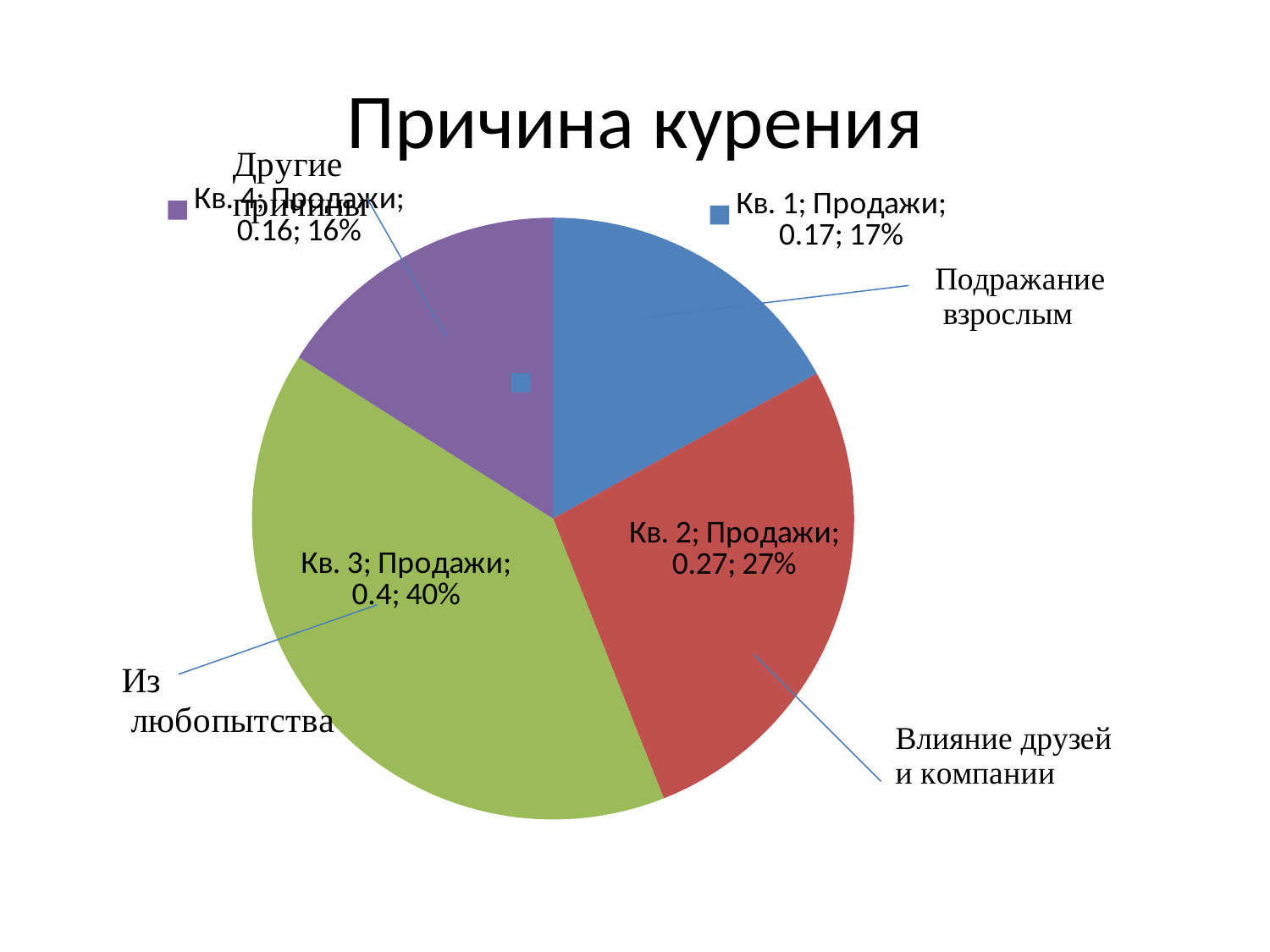
What value is shown for the Кв. 1 slice? 0.17 What is the title of the chart? Причина курения What percentage is shown for the Кв. 4 slice? 16% What percentage is shown for the Кв. 3 slice? 40% Which slice is larger, Кв. 1 or Кв. 2? Кв. 2 Which slice has the largest share of the pie? Кв. 3 Which slice has the smallest share of the pie? Кв. 4 How many slices does the pie chart have? 4 What type of chart is shown on the slide? pie chart What is the difference in percentage points between the Кв. 3 slice and the Кв. 2 slice? 13 Which reason is annotated next to the green slice (Кв. 3)? Из любопытства What percentage is shown for the Кв. 2 slice? 27%